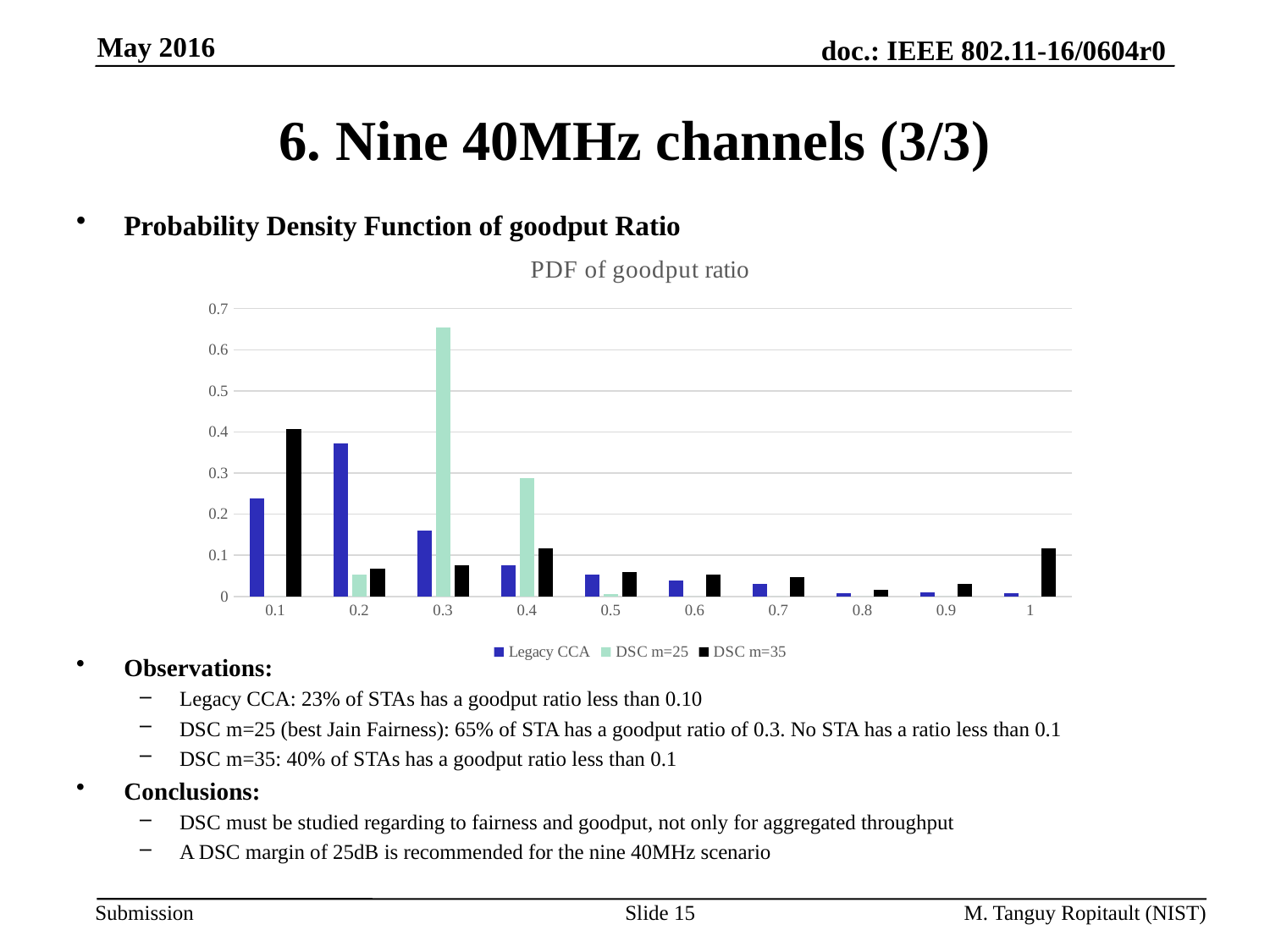
At which x-axis category does the Legacy CCA series reach its highest value? 0.2 Is the value for Legacy CCA at 0.2 greater or less than 0.3? greater At which x-axis category does the DSC m=35 series reach its highest value? 0.1 Which series is shown in black in the chart? DSC m=35 Is the value for DSC m=25 at 0.3 greater or less than 0.6? greater How many series does the chart legend list? 3 Is the value for Legacy CCA at 0.3 greater or less than 0.2? less What is the title of the chart? PDF of goodput ratio How many categories are shown along the x axis of the chart? 10 At the 0.1 category, which series has the larger value, Legacy CCA or DSC m=35? DSC m=35 At which x-axis category does the DSC m=25 series reach its highest value? 0.3 What kind of chart is shown on the slide? bar chart